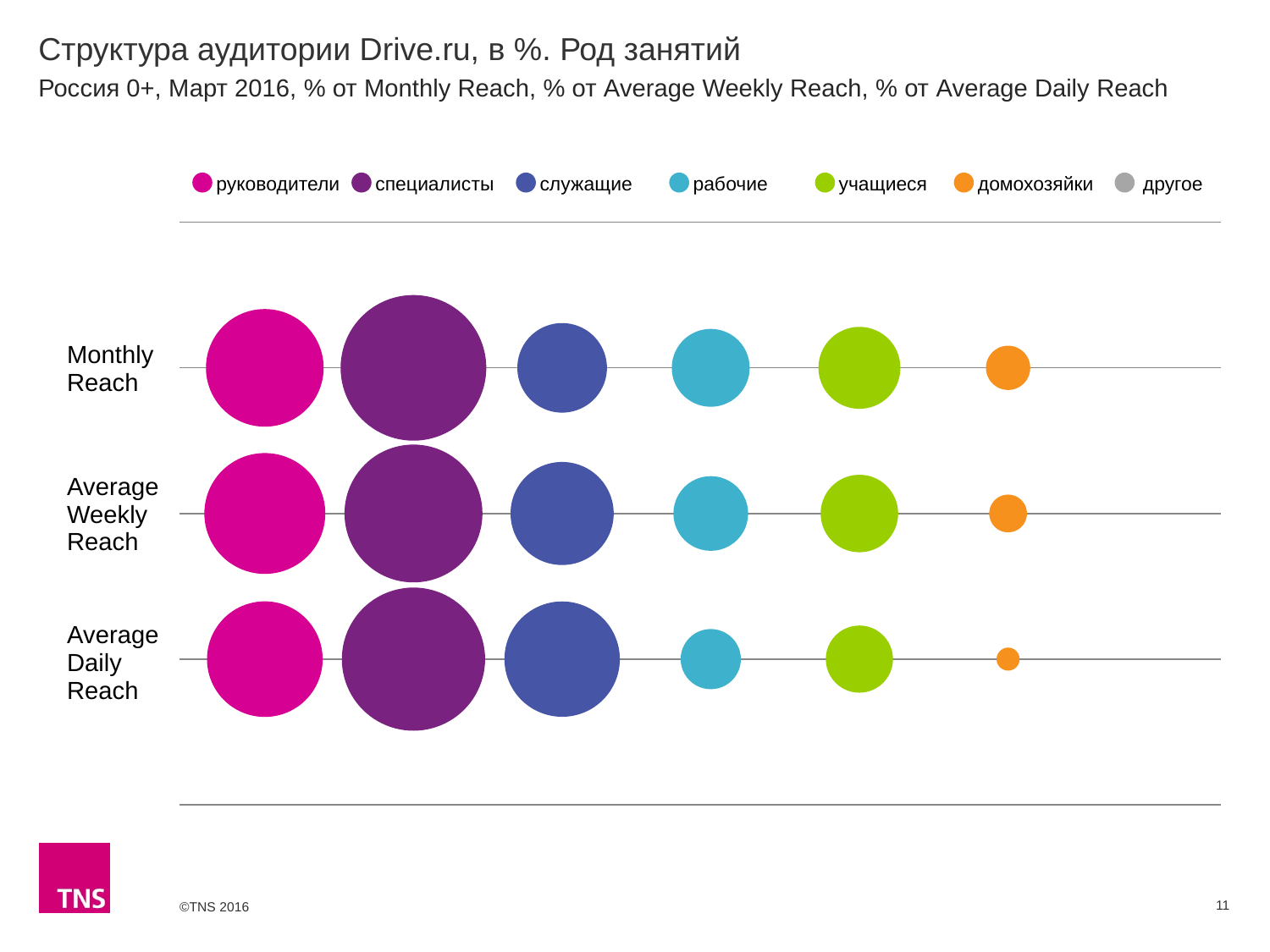
Which occupation group has the largest bubble in the Average Daily Reach row? специалисты In the Average Weekly Reach row, which bubble is larger: служащие or домохозяйки? служащие How many series does the legend list? 7 Does the bubble for домохозяйки get larger or smaller going from Monthly Reach to Average Daily Reach? smaller Which colour represents учащиеся in the legend? green In the Monthly Reach row, which bubble is larger: руководители or специалисты? специалисты Among the bubbles shown in the Average Daily Reach row, which occupation group has the smallest bubble? домохозяйки Which occupation group has the largest bubble in the Monthly Reach row? специалисты How many reach categories (rows) are plotted on the chart? 3 What kind of chart is shown on the slide? bubble chart In the Average Daily Reach row, which bubble is larger: рабочие or учащиеся? учащиеся What is the title of the chart on the slide? Структура аудитории Drive.ru, в %. Род занятий